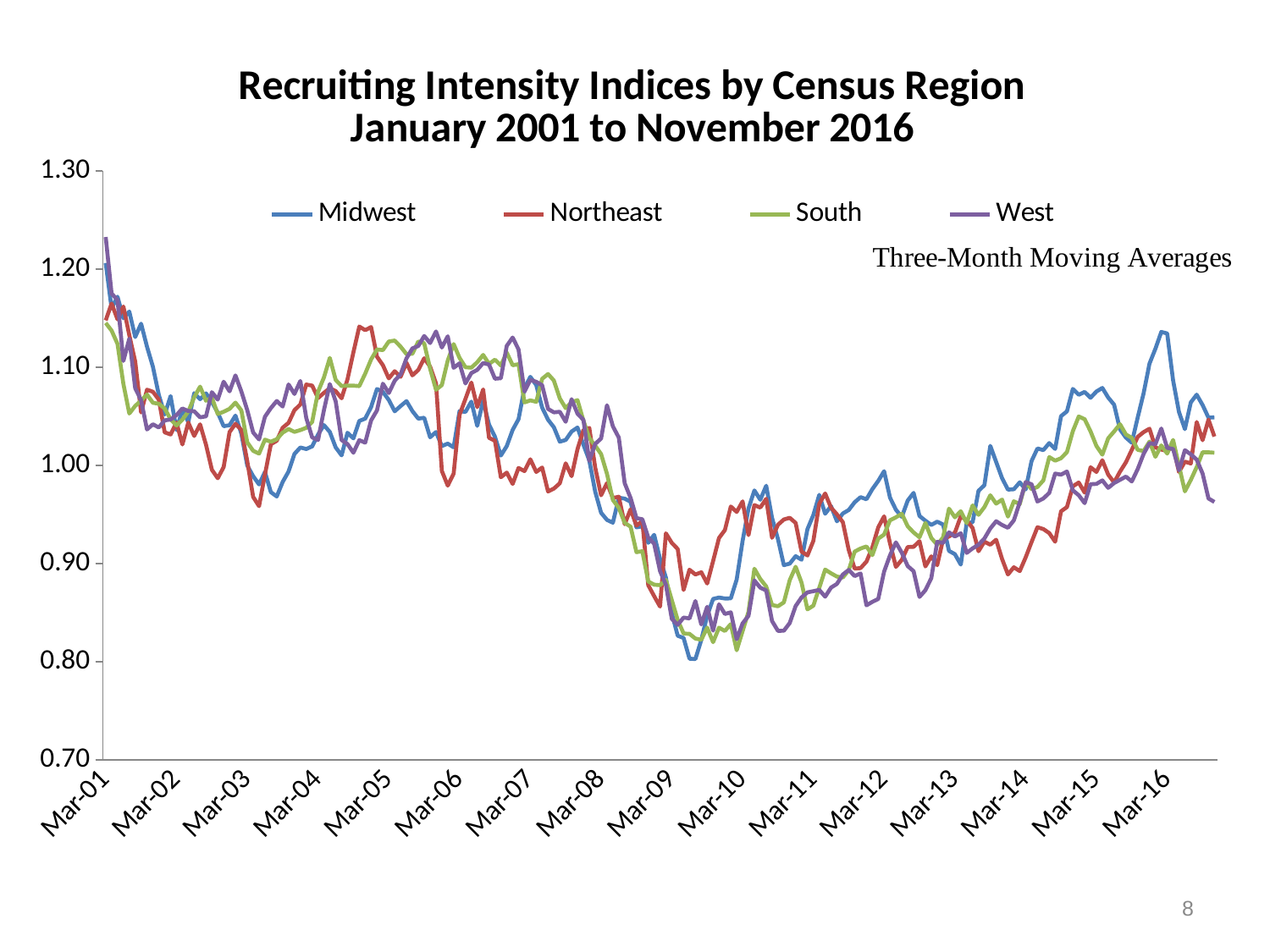
Is the highest value reached by any line at the start of the chart greater or less than 1.20? greater Around Mar-05, is the value for Northeast greater or less than 1.00? greater Is the lowest value reached by the Midwest line greater or less than 0.90? less What kind of chart is shown on the slide? line chart Around Mar-14, which is larger, the Midwest value or the Northeast value? Midwest Which series reaches the lowest point anywhere on the chart? Midwest How many series does the legend list? 4 Which series is lowest at the right-hand end of the chart? West Which four regions are listed in the legend? Midwest, Northeast, South, West Do the lines generally rise or fall between Mar-08 and Mar-09? fall What note appears below the legend describing how the series are computed? Three-Month Moving Averages